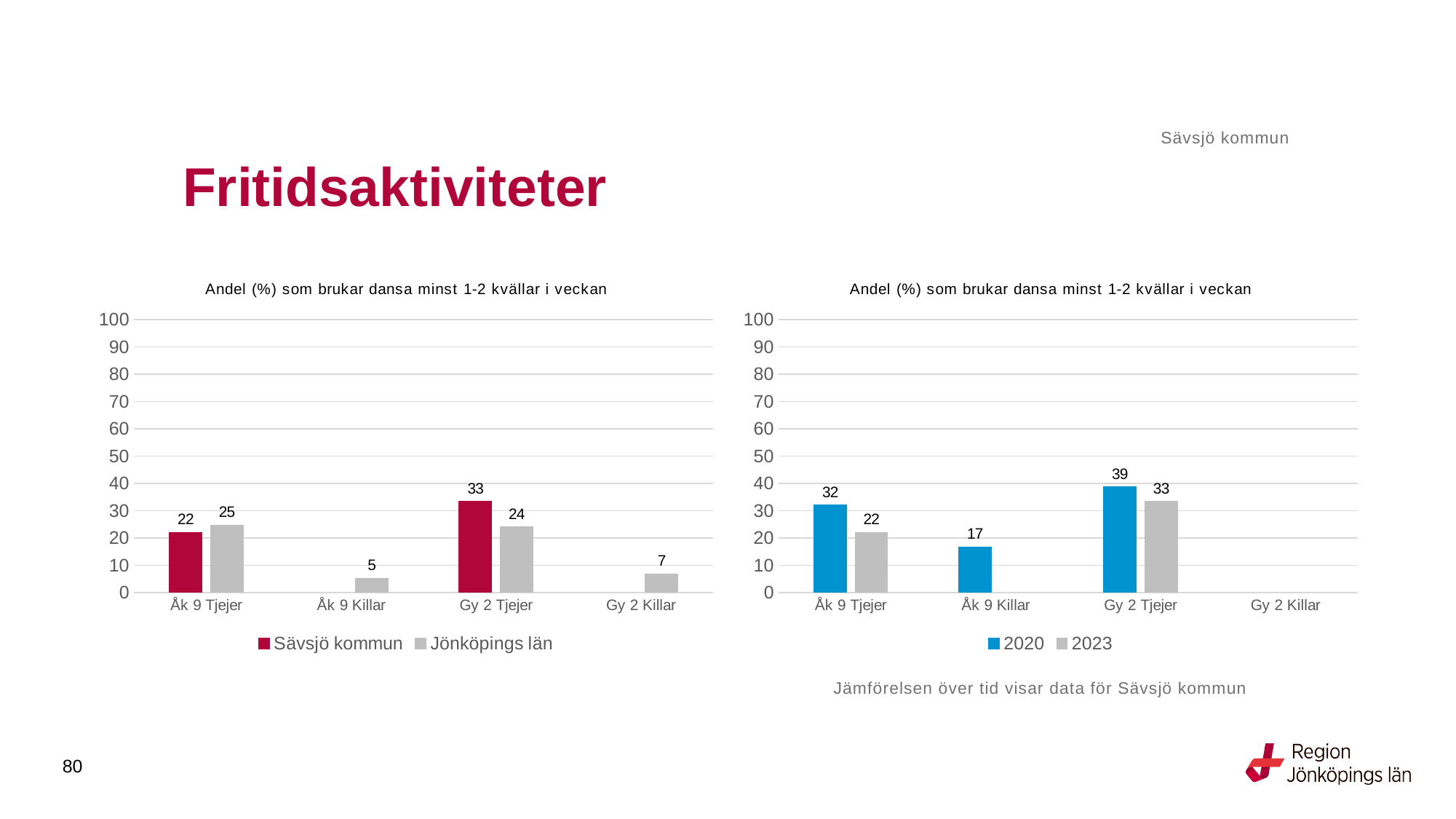
In the right chart, which category has the highest value for 2020? Gy 2 Tjejer In the left chart, how many series does the legend list? 2 In the right chart, what is the value for 2020 for Åk 9 Killar? 17 In the left chart, which category has the highest value for Jönköpings län? Åk 9 Tjejer In the left chart, what is the value for Sävsjö kommun for Gy 2 Tjejer? 33 In the left chart, what is the value for Jönköpings län for Åk 9 Killar? 5 In the left chart, what is the difference between Sävsjö kommun and Jönköpings län for Gy 2 Tjejer? 9 What kind of chart is the right chart? Bar chart How many categories are shown on the x axis of the right chart? 4 In the left chart, which is larger for Åk 9 Tjejer: Sävsjö kommun or Jönköpings län? Jönköpings län In the right chart, what is the difference between 2020 and 2023 for Åk 9 Tjejer? 10 In the right chart, what is the value for 2023 for Gy 2 Tjejer? 33